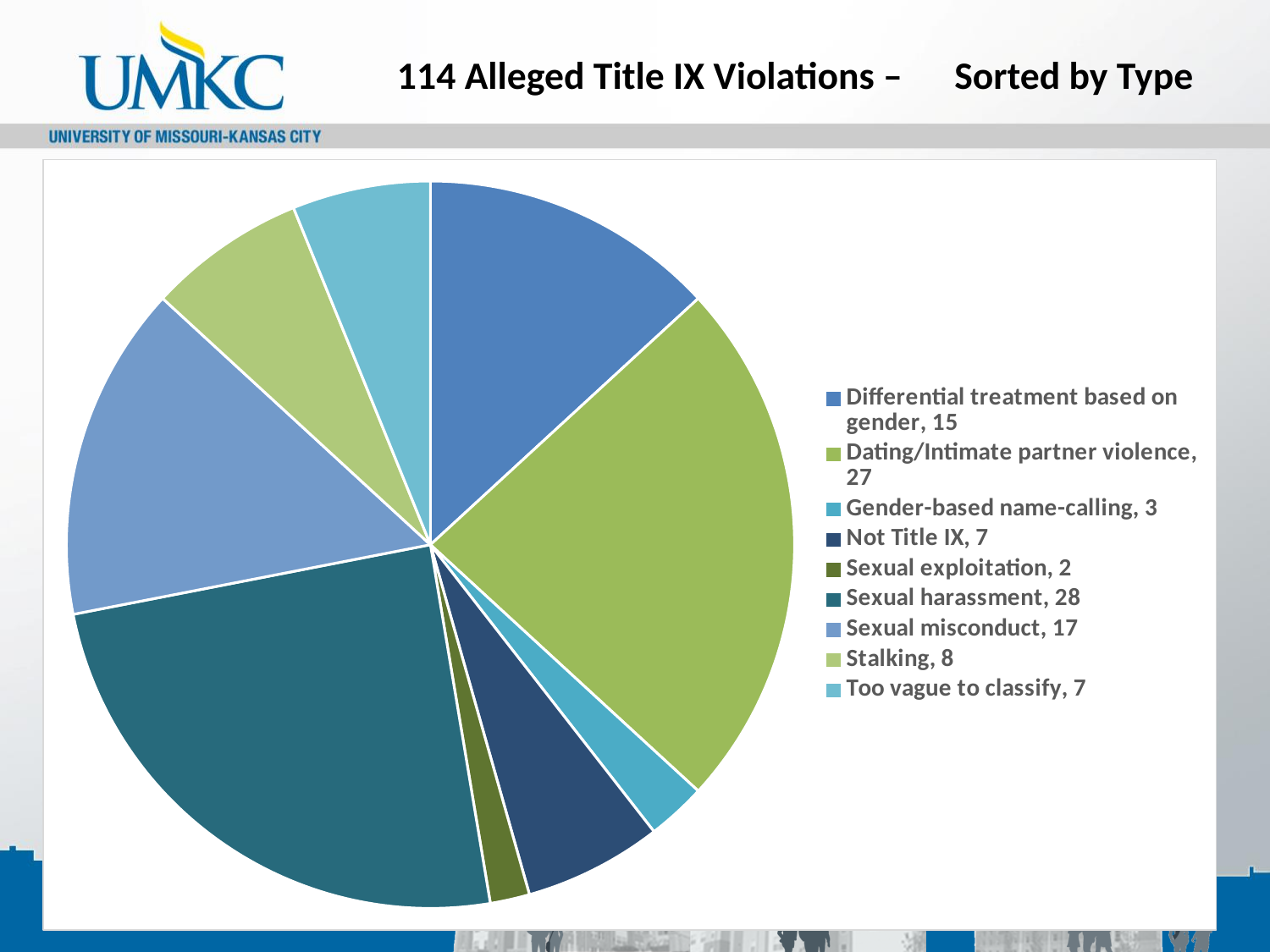
What is the value for Sexual harassment? 28 What is the title of the slide? 114 Alleged Title IX Violations – Sorted by Type What is the total of all the slices in the pie chart? 114 What is the difference between Sexual harassment and Sexual misconduct? 11 What is the value for Too vague to classify? 7 Which category has the highest value? Sexual harassment Which category has the lowest value? Sexual exploitation Which is larger, Stalking or Not Title IX? Stalking What is the value for Sexual misconduct? 17 What type of chart is shown on the slide? Pie chart What is the value for Dating/Intimate partner violence? 27 How many categories does the pie chart show? 9